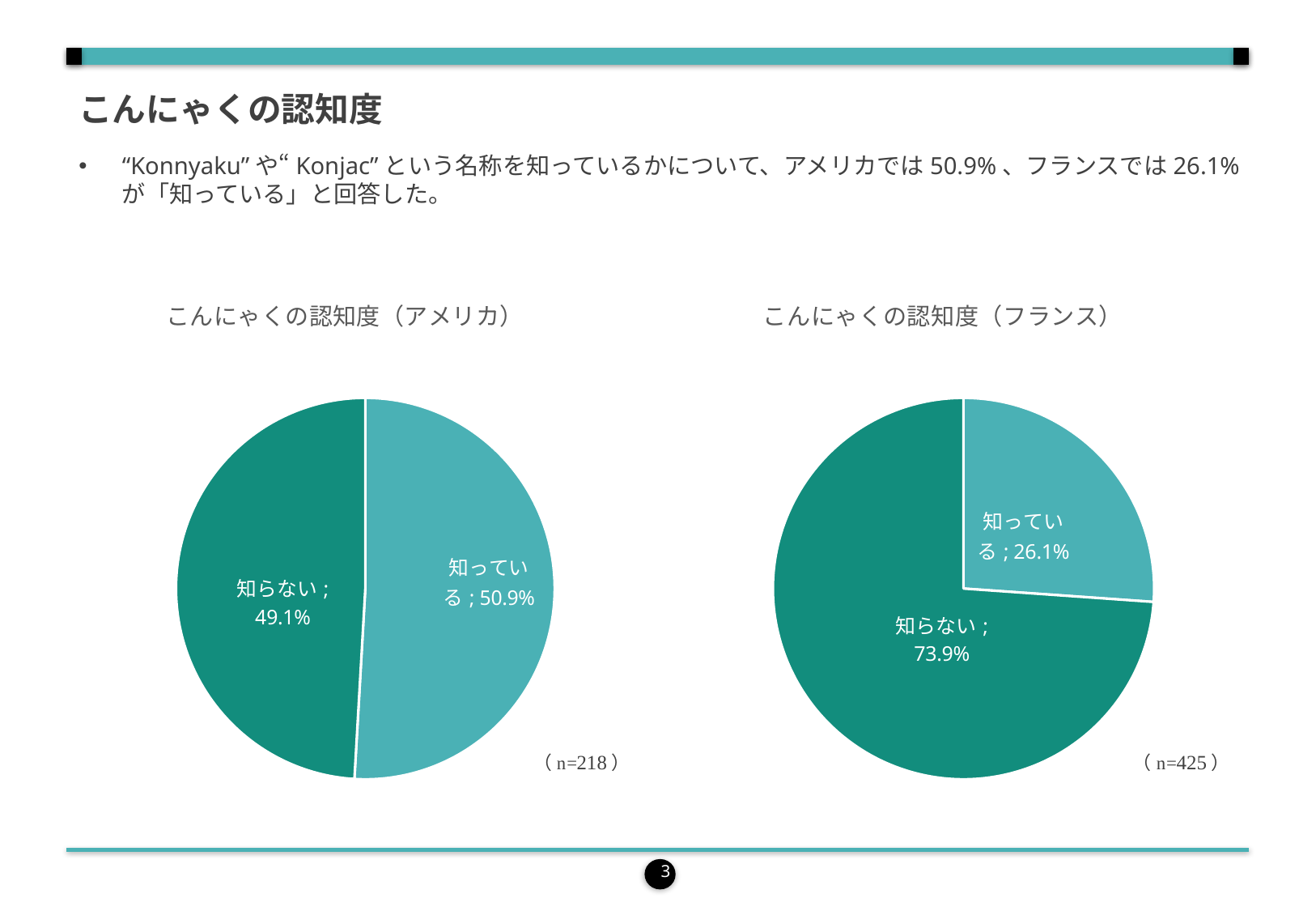
In the chart titled こんにゃくの認知度（フランス）, what share of respondents answered 知らない? 73.9% In the chart titled こんにゃくの認知度（フランス）, what share of respondents answered 知っている? 26.1% How many slices does the chart titled こんにゃくの認知度（フランス） have? 2 What is the sample size (n) shown for the chart titled こんにゃくの認知度（フランス）? n=425 In the chart titled こんにゃくの認知度（フランス）, what is the difference between the 知らない and 知っている shares? 47.8% In the chart titled こんにゃくの認知度（アメリカ）, what share of respondents answered 知っている? 50.9% In the chart titled こんにゃくの認知度（フランス）, which slice is the largest? 知らない In the chart titled こんにゃくの認知度（アメリカ）, what is the difference between the 知っている and 知らない shares? 1.8% In the chart titled こんにゃくの認知度（フランス）, which slice is the smallest? 知っている In the chart titled こんにゃくの認知度（アメリカ）, what share of respondents answered 知らない? 49.1% What kind of chart is the chart titled こんにゃくの認知度（アメリカ）? pie chart Which chart shows a larger 知っている share, こんにゃくの認知度（アメリカ） or こんにゃくの認知度（フランス）? こんにゃくの認知度（アメリカ）